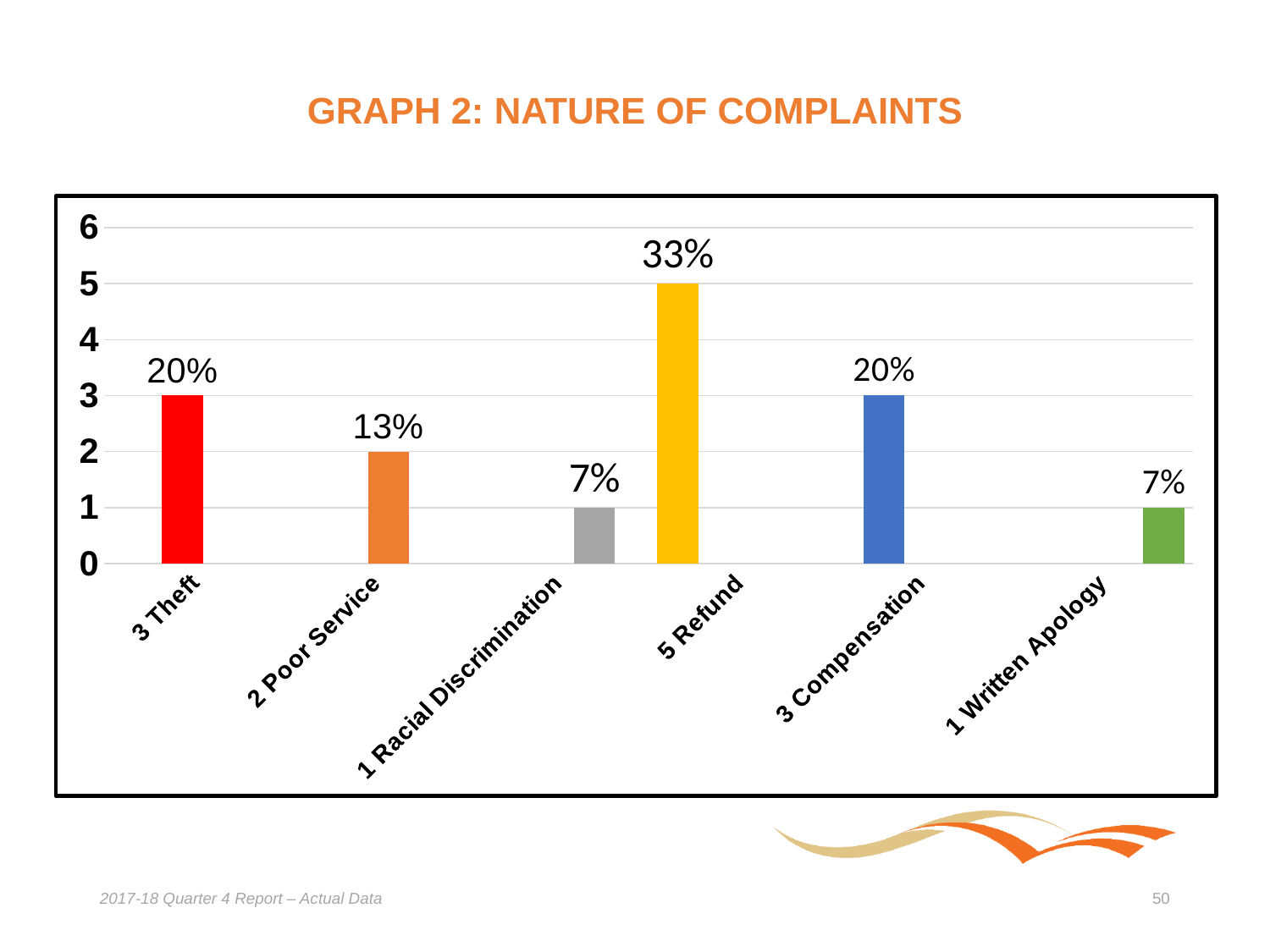
What is the difference in percentage points between the Refund label and the Compensation label? 13 Is the value for Refund greater or less than 4? greater What kind of chart is shown on the slide? Bar chart What percentage label is shown on the Poor Service bar? 13% What is the title of the chart? GRAPH 2: NATURE OF COMPLAINTS What percentage label is shown on the Theft bar? 20% Which bar is taller, Theft or Poor Service? Theft How many categories are shown on the chart? 6 Which category has the highest bar? Refund What percentage label is shown on the Written Apology bar? 7% What percentage label is shown on the Refund bar? 33% How many complaints does the Refund bar reach on the vertical axis? 5